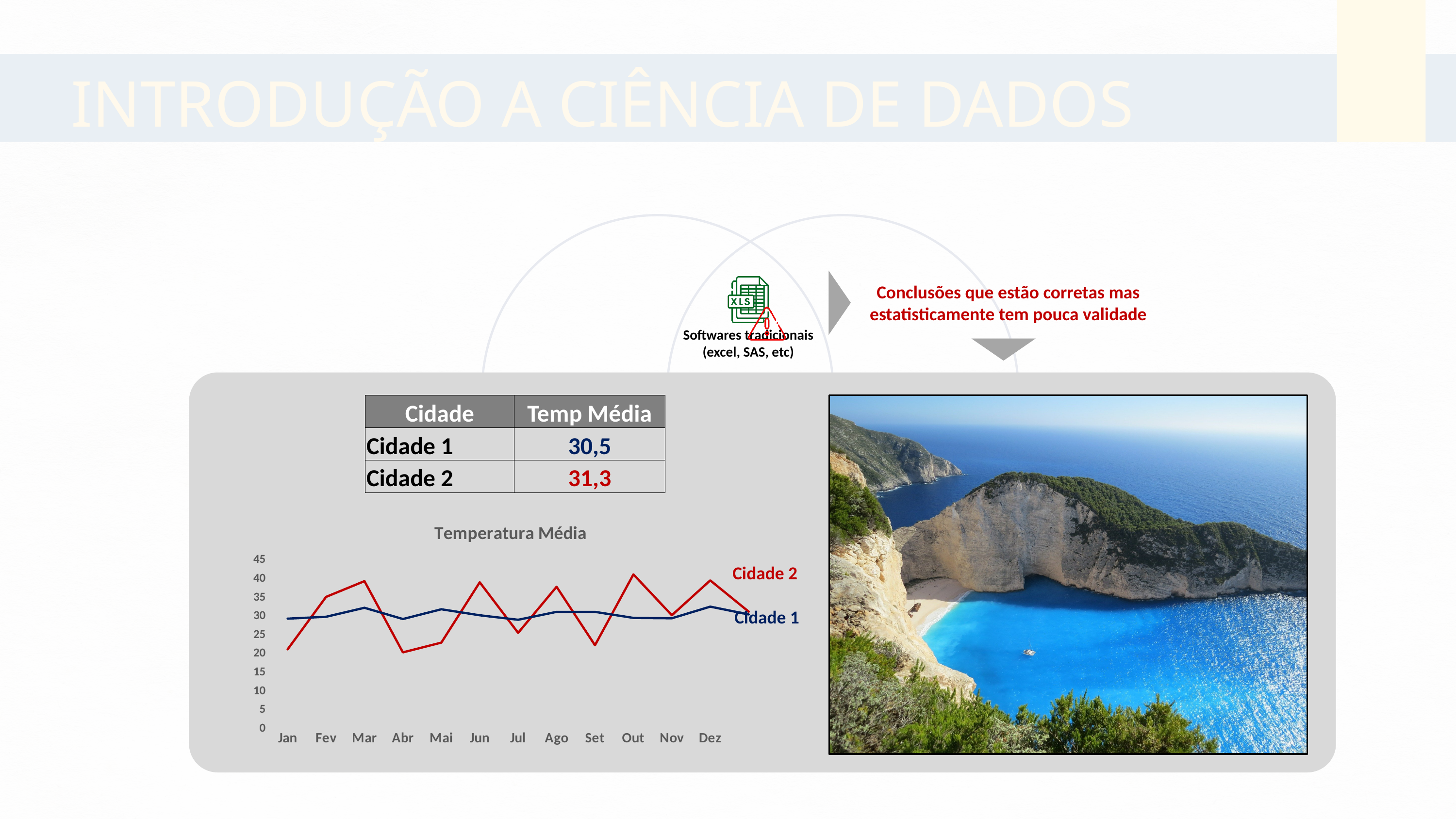
Is the value for Cidade 1 in Mar greater or less than 35? less Is the value for Cidade 2 in Jan greater or less than 25? less How many months are shown on the x axis of the chart? 12 In Abr, which series has the higher value, Cidade 1 or Cidade 2? Cidade 1 Is the value for Cidade 2 in Out greater or less than 35? greater What is the title of the chart? Temperatura Média What kind of chart is shown on the slide? line chart What colour is the line for Cidade 2 in the chart? red How many series are plotted in the chart? 2 In Out, which series has the higher value, Cidade 1 or Cidade 2? Cidade 2